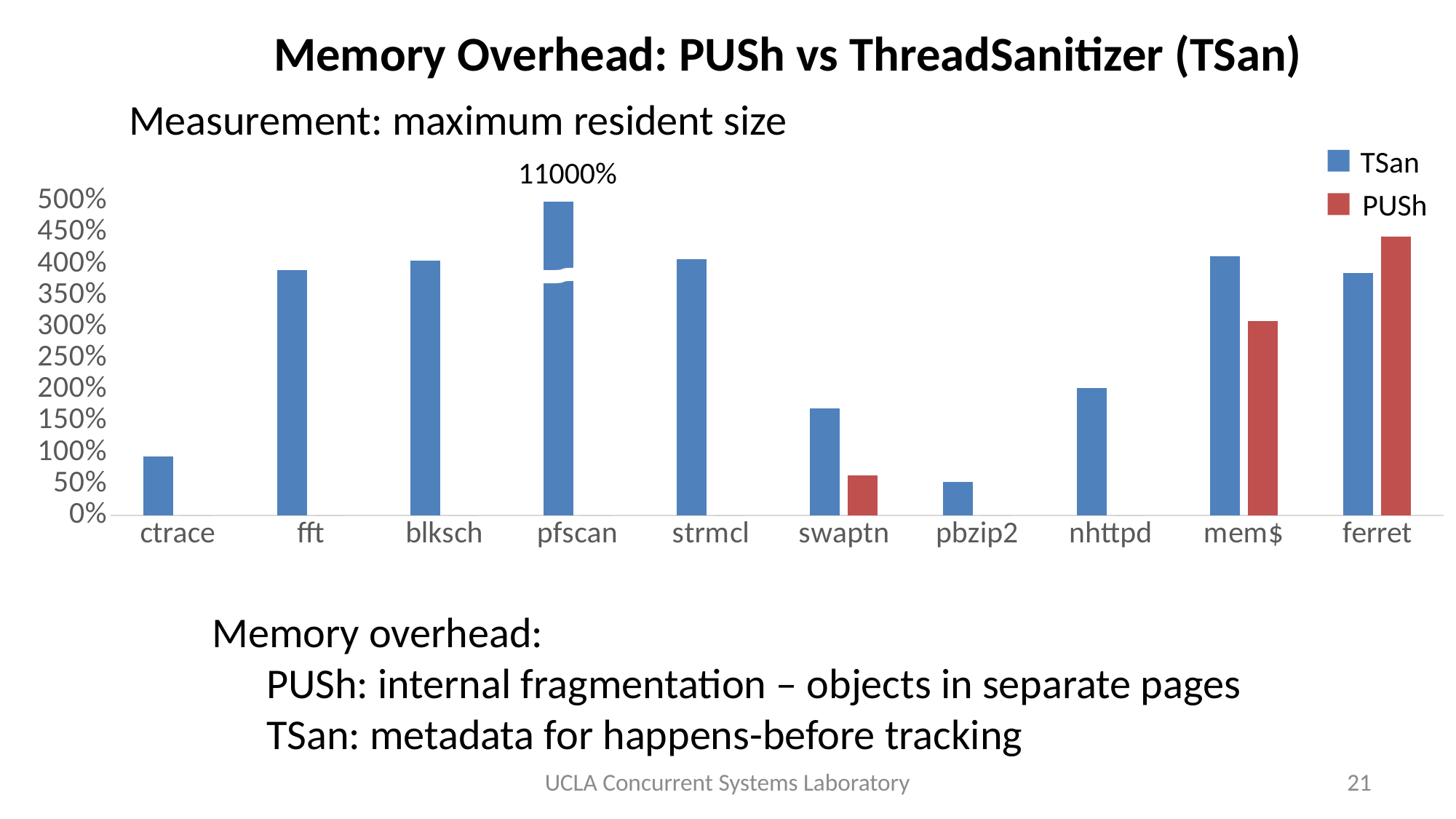
For ferret, which is larger: the TSan value or the PUSh value? PUSh Is the TSan value for swaptn greater or less than 150%? greater Which benchmark has the highest TSan memory overhead? pfscan What is the TSan memory overhead value labelled for pfscan? 11000% What type of chart is shown on the slide? bar chart How many series does the legend list? 2 Is the PUSh value for ferret greater or less than 400%? greater How many benchmark categories are shown on the x axis? 10 For mem$, which is larger: the TSan value or the PUSh value? TSan Is the TSan value for ctrace greater or less than 100%? less What colour are the PUSh bars in the chart? red